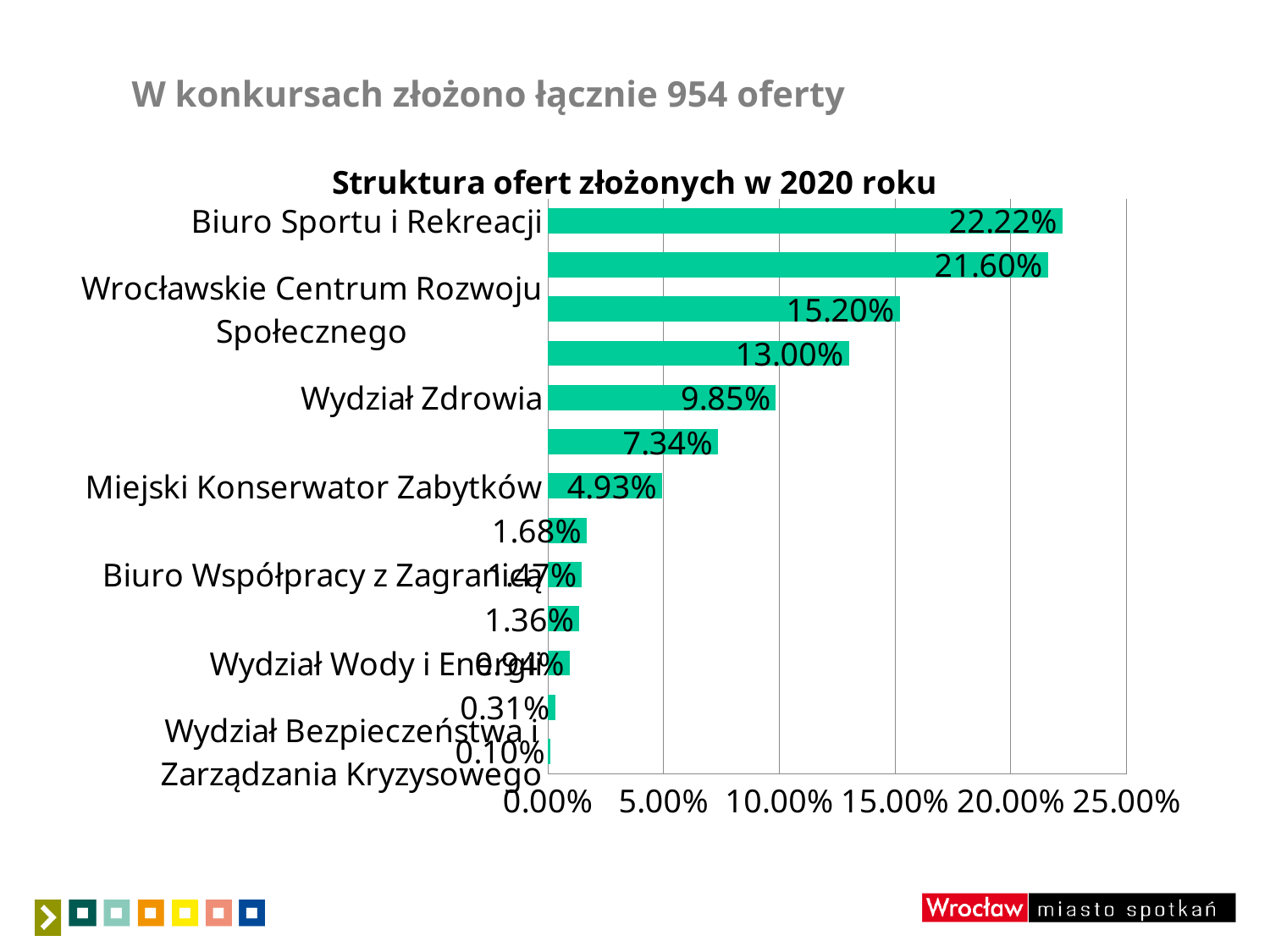
What is the value for Wydział Zdrowia? 9.85% What is the difference between the values for Biuro Sportu i Rekreacji and Wydział Zdrowia? 12.37% What is the title of the chart? Struktura ofert złożonych w 2020 roku What is the value for Wydział Bezpieczeństwa i Zarządzania Kryzysowego? 0.10% Is the value for Biuro Sportu i Rekreacji greater or less than 20.00%? greater How many bars are plotted in the chart? 13 Which category has the lowest value? Wydział Bezpieczeństwa i Zarządzania Kryzysowego What is the value for Miejski Konserwator Zabytków? 4.93% Which category has the highest value? Biuro Sportu i Rekreacji Which is larger, the value for Wydział Zdrowia or the value for Miejski Konserwator Zabytków? Wydział Zdrowia What is the value for Biuro Sportu i Rekreacji? 22.22% What is the value for Wrocławskie Centrum Rozwoju Społecznego? 15.20%